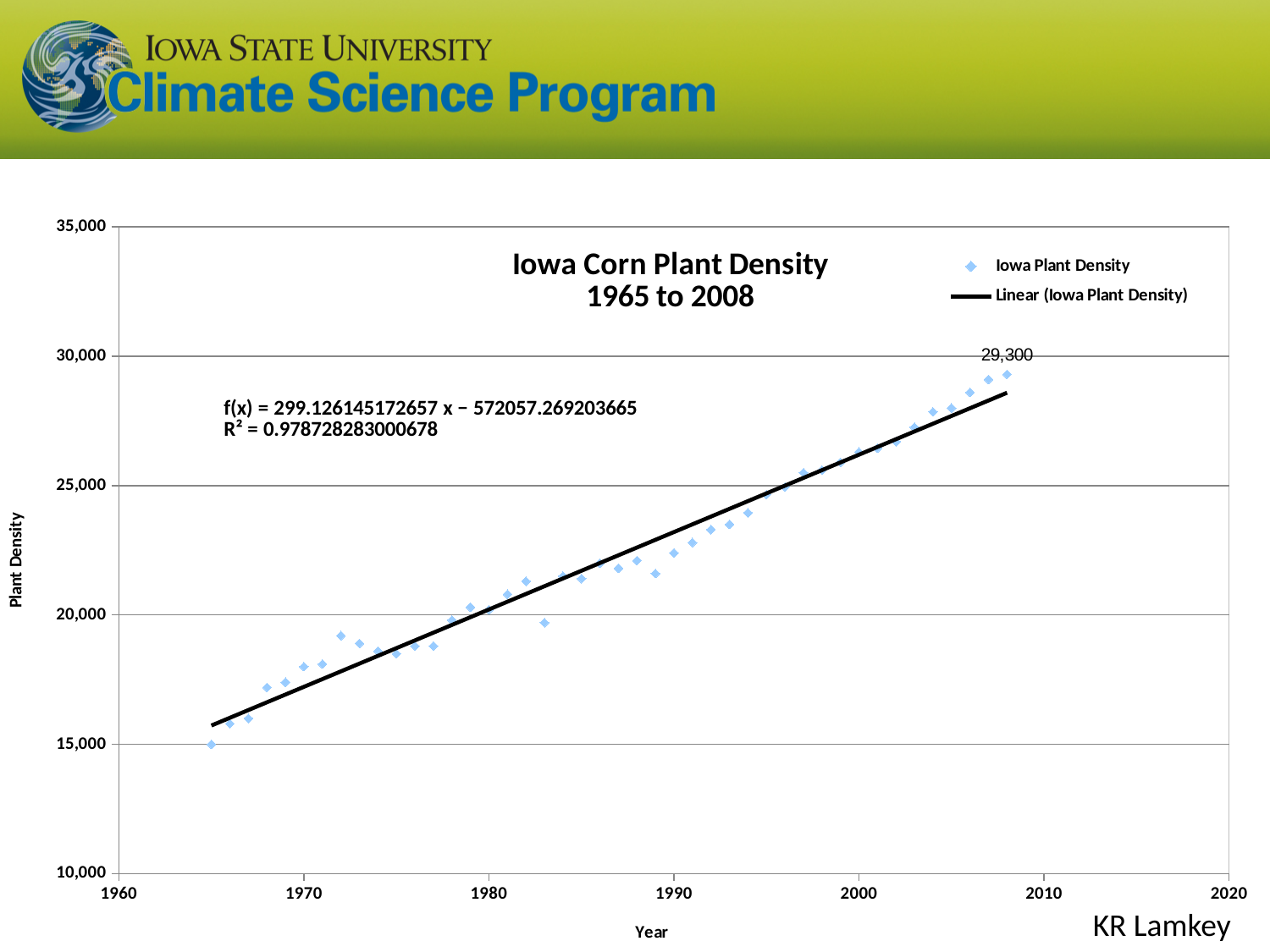
Which year has the larger plant density, 1985 or 2005? 2005 Is the plant density value for 2000 greater or less than 25,000? greater Is the plant density value for 1972 greater or less than 20,000? less What is the R² value shown for the linear trendline? 0.978728283000678 Is the plant density value for 1990 greater or less than 25,000? less What is the title of the chart? Iowa Corn Plant Density 1965 to 2008 Which year has the highest plant density? 2008 How many entries does the chart legend list? 2 Which year has the lowest plant density? 1965 What kind of chart is shown on the slide? scatter chart Do the plant density values generally rise or fall as the year increases? rise What is the plant density value labelled at the last data point (2008)? 29,300